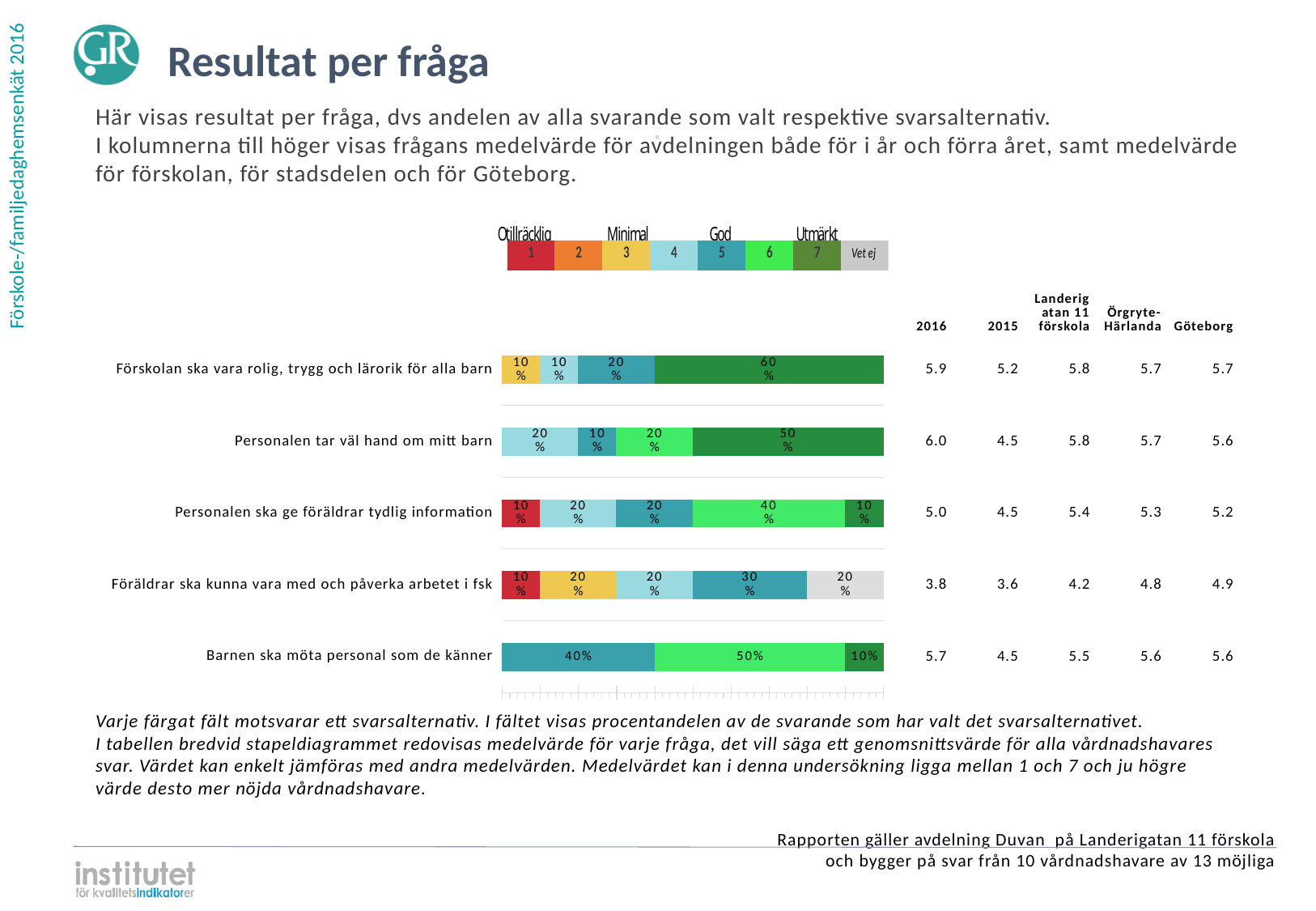
How many questions (categories) are plotted in the bar chart? 5 For "Personalen tar väl hand om mitt barn", which is larger: the share for rating 4 (light blue) or the share for rating 5 (teal)? Rating 4 (20%) What percentage of respondents chose rating 7 (dark green) for "Förskolan ska vara rolig, trygg och lärorik för alla barn"? 60% What kind of chart is shown on the slide? Stacked bar chart What percentage of respondents chose rating 5 (teal) for "Barnen ska möta personal som de känner"? 40% What is the 2016 mean value shown for "Personalen tar väl hand om mitt barn"? 6.0 Which question has the largest share of respondents choosing rating 7 (dark green)? Förskolan ska vara rolig, trygg och lärorik för alla barn What percentage of respondents chose rating 6 (bright green) for "Personalen ska ge föräldrar tydlig information"? 40% What is the difference between the rating 6 share and the rating 7 share for "Barnen ska möta personal som de känner"? 40% What percentage of respondents chose rating 7 (dark green) for "Personalen tar väl hand om mitt barn"? 50% What percentage of respondents answered "Vet ej" (grey) for "Föräldrar ska kunna vara med och påverka arbetet i fsk"? 20% How many response categories does the legend above the chart list, including "Vet ej"? 8